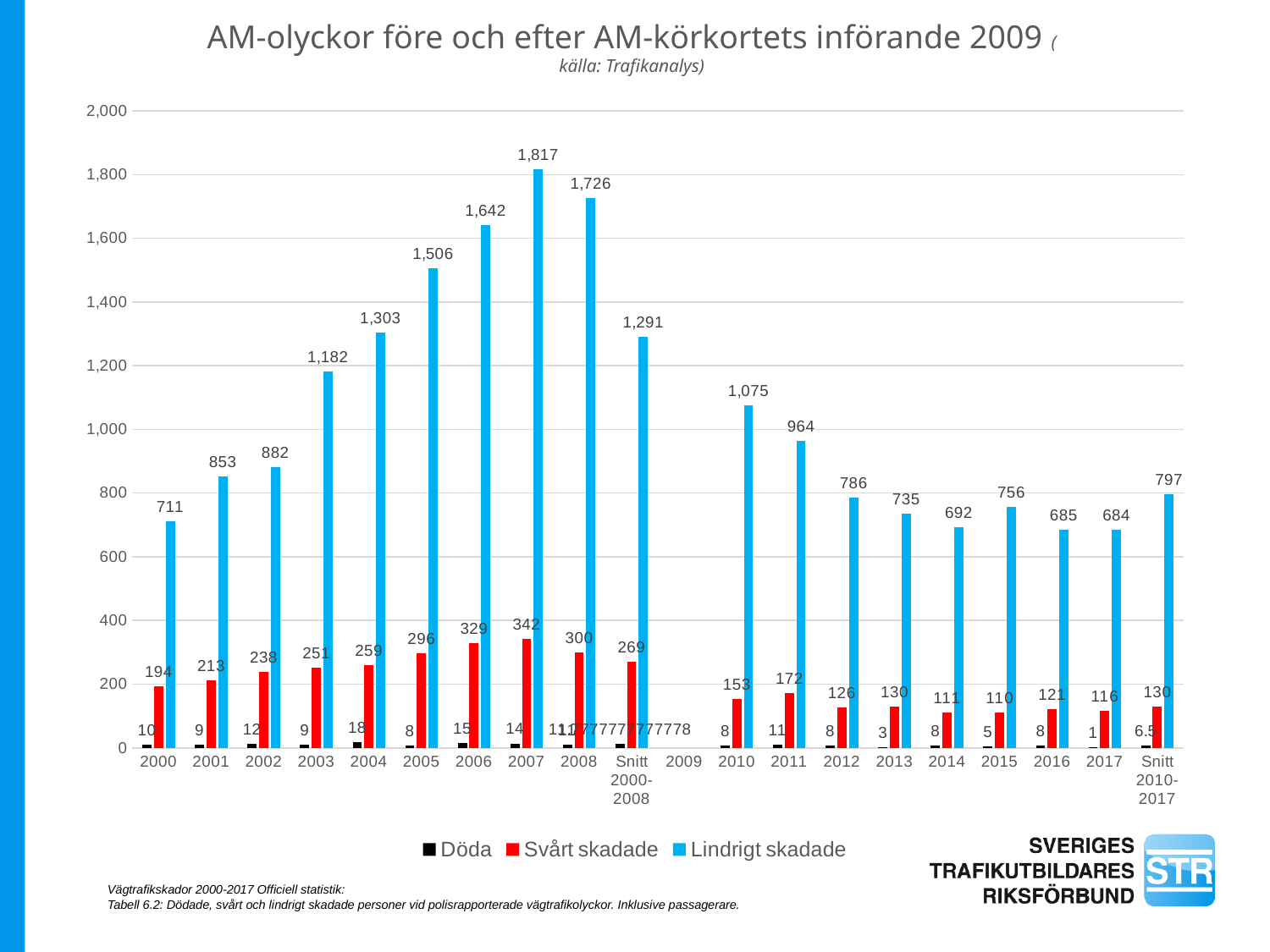
How many series does the legend list? 3 Which year has the lowest value for Döda? 2017 What is the value of Svårt skadade for 2005? 296 What is the value of Döda for 2004? 18 What is the Lindrigt skadade value for Snitt 2010-2017? 797 Which year has the highest value for Lindrigt skadade? 2007 What kind of chart is shown on the slide? Bar chart What is the difference between the Lindrigt skadade values for 2008 and 2010? 651 What is the value of Lindrigt skadade for 2007? 1,817 Do the Lindrigt skadade values rise or fall from 2000 to 2007? Rise What is the difference between the Svårt skadade values for Snitt 2000-2008 and Snitt 2010-2017? 139 Which year has the larger Lindrigt skadade value, 2001 or 2002? 2002